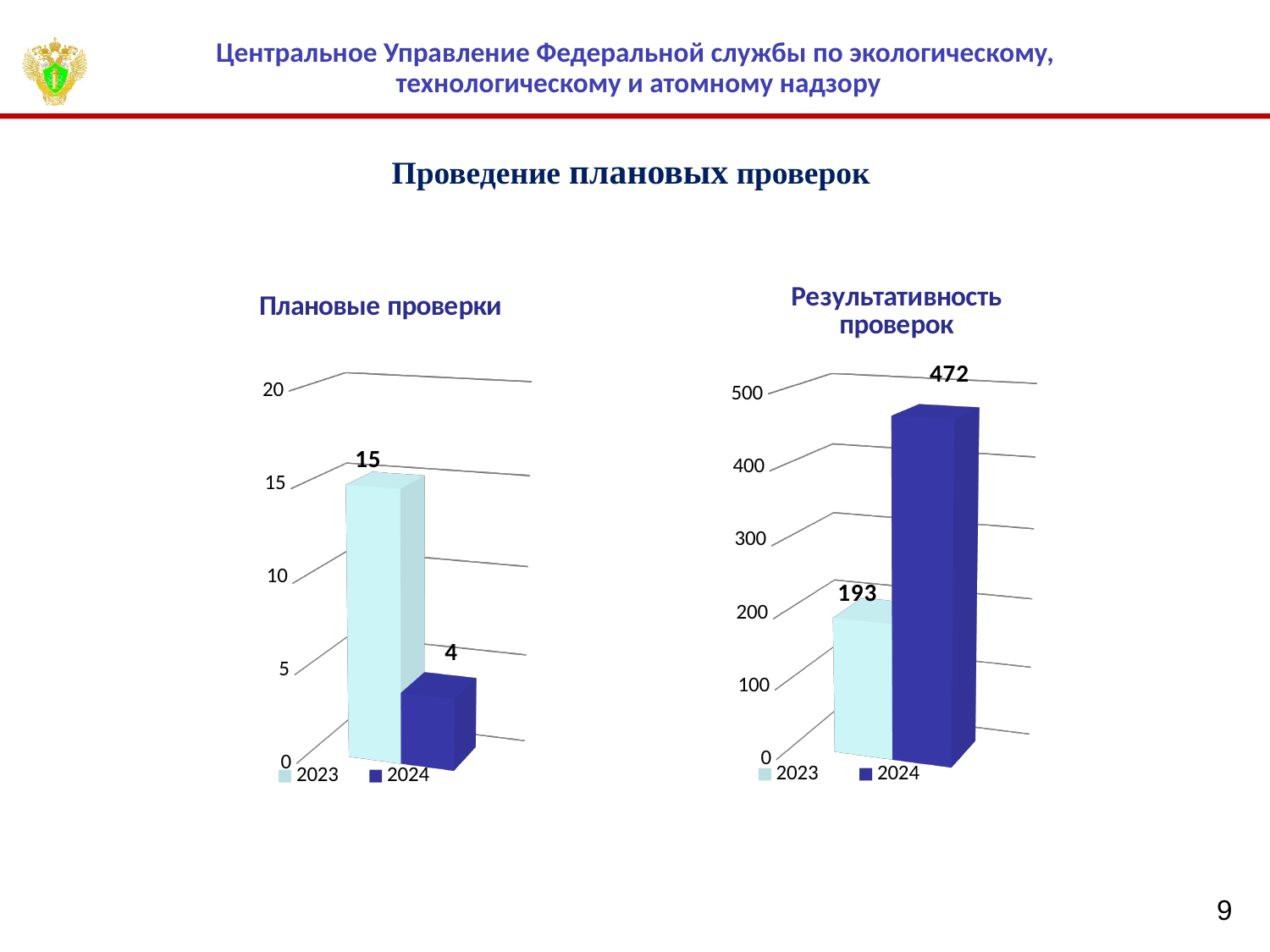
In the 'Результативность проверок' chart, what is the value for 2023? 193 In the 'Плановые проверки' chart, what is the value for 2024? 4 In the 'Результативность проверок' chart, which colour represents 2024? Dark blue In the 'Плановые проверки' chart, what is the difference between the 2023 and 2024 values? 11 In the 'Плановые проверки' chart, which year has the higher value? 2023 In the 'Плановые проверки' chart, what is the value for 2023? 15 In the 'Результативность проверок' chart, what is the value for 2024? 472 In the 'Результативность проверок' chart, which year has the lower value? 2023 In the 'Результативность проверок' chart, is the value for 2024 larger than the value for 2023? Yes How many series does the legend of the 'Плановые проверки' chart list? 2 In the 'Результативность проверок' chart, what is the difference between the 2024 and 2023 values? 279 What kind of chart is the 'Результативность проверок' chart? Bar chart